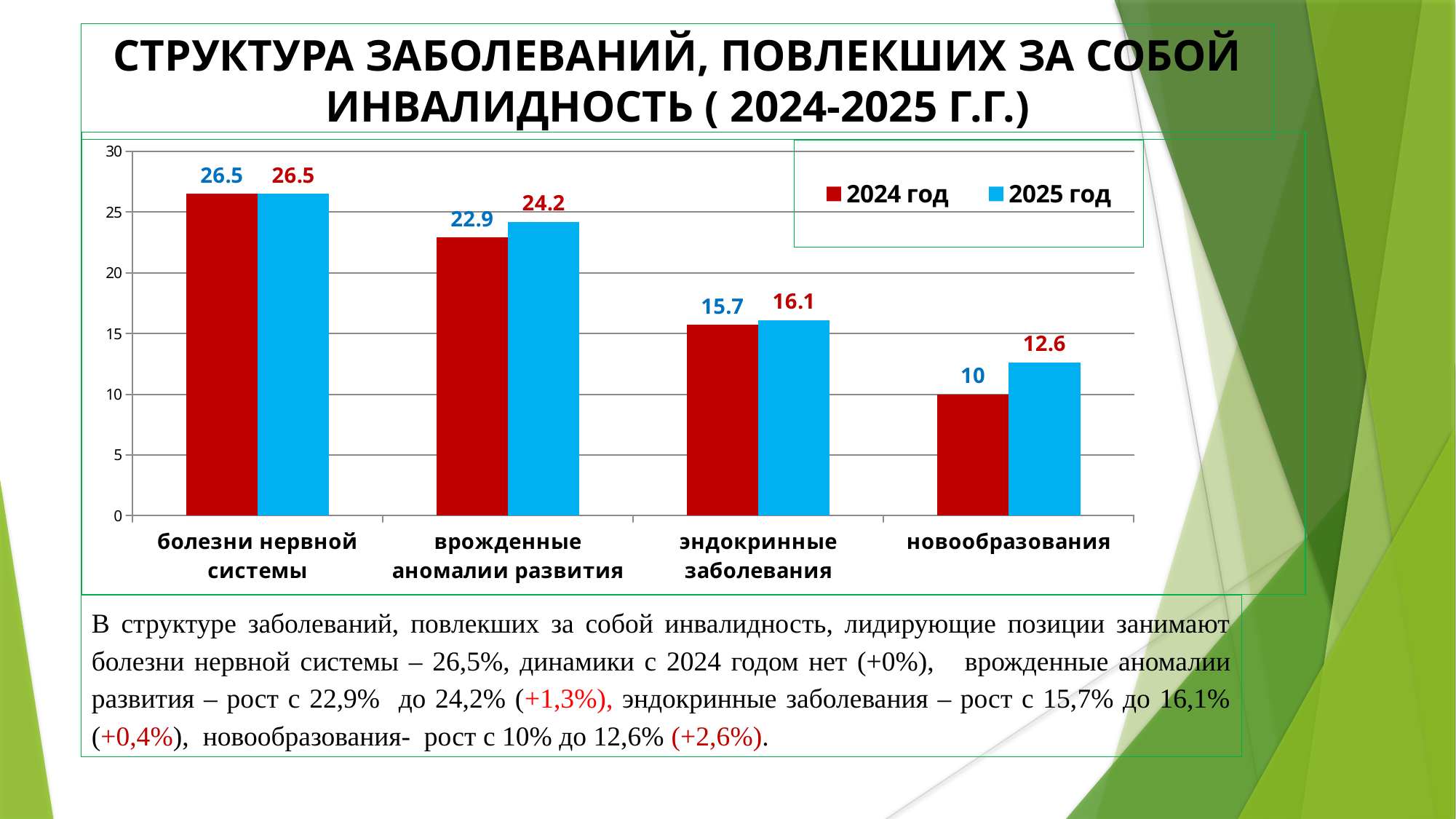
How many categories are shown on the x axis? 4 What is the value for 2025 год for новообразования? 12.6 What is the value for 2025 год for эндокринные заболевания? 16.1 What is the value for 2024 год for врожденные аномалии развития? 22.9 How many series does the legend list? 2 Which category has the highest value for 2025 год? болезни нервной системы Which category has the lowest value for 2024 год? новообразования What is the difference between the 2025 год and 2024 год values for новообразования? 2.6 Do the 2024 год values rise or fall from left to right across the categories? fall What kind of chart is shown on the slide? bar chart Which is larger for врожденные аномалии развития: the 2024 год value or the 2025 год value? 2025 год What is the value for 2024 год for болезни нервной системы? 26.5